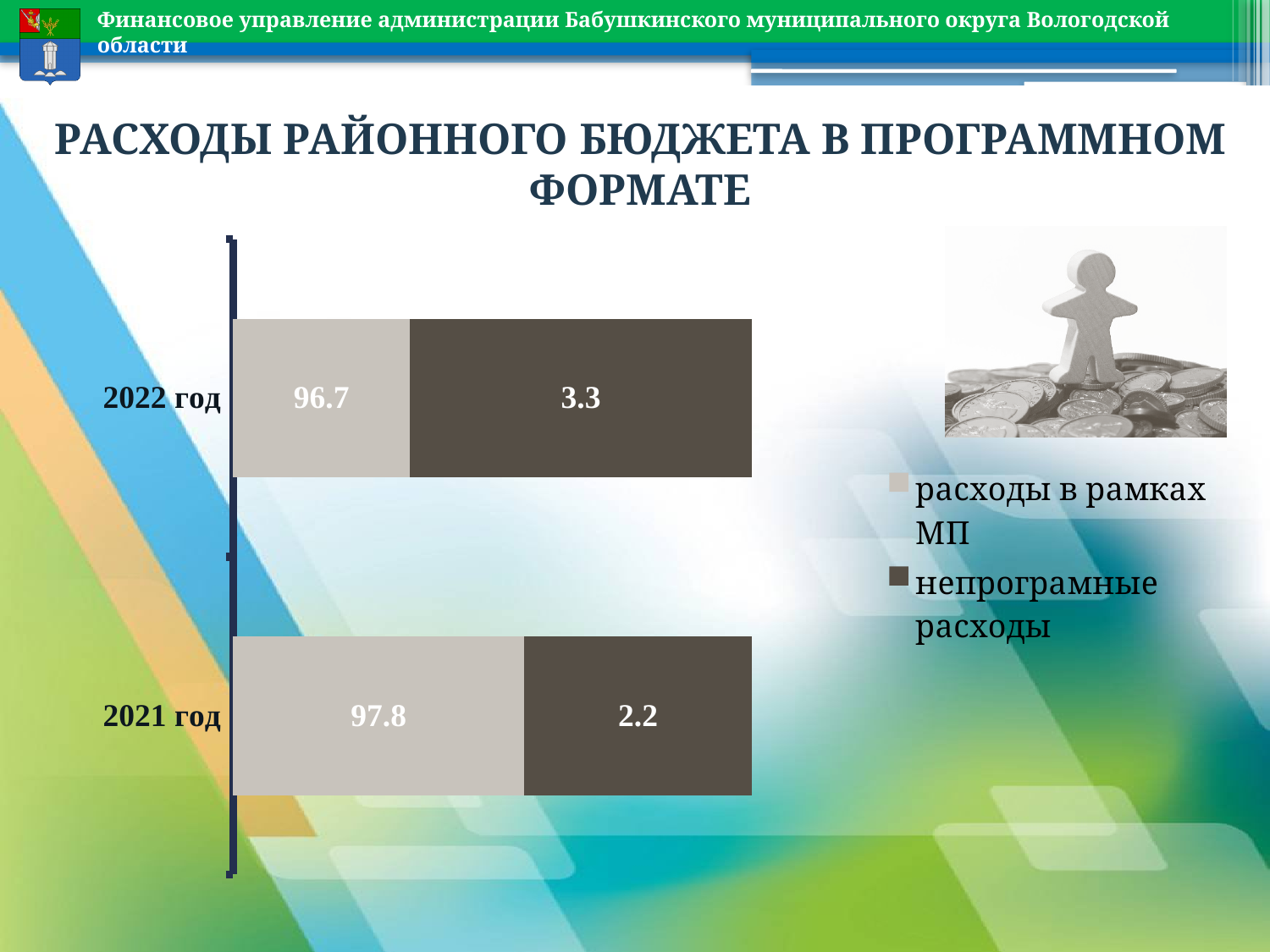
Which year has the lower value for "расходы в рамках МП"? 2022 год What is the total of the stacked bar for 2022 год? 100 How many series does the legend list? 2 What is the value for "расходы в рамках МП" in 2022 год? 96.7 What is the value for "непрограмные расходы" in 2022 год? 3.3 What is the value for "расходы в рамках МП" in 2021 год? 97.8 What kind of chart is shown on the slide? Stacked bar chart Is the value for "непрограмные расходы" larger in 2021 год or in 2022 год? 2022 год What is the difference between the "расходы в рамках МП" values for 2021 год and 2022 год? 1.1 What is the value for "непрограмные расходы" in 2021 год? 2.2 Which year has the higher value for "непрограмные расходы"? 2022 год How many years (categories) are shown in the chart? 2